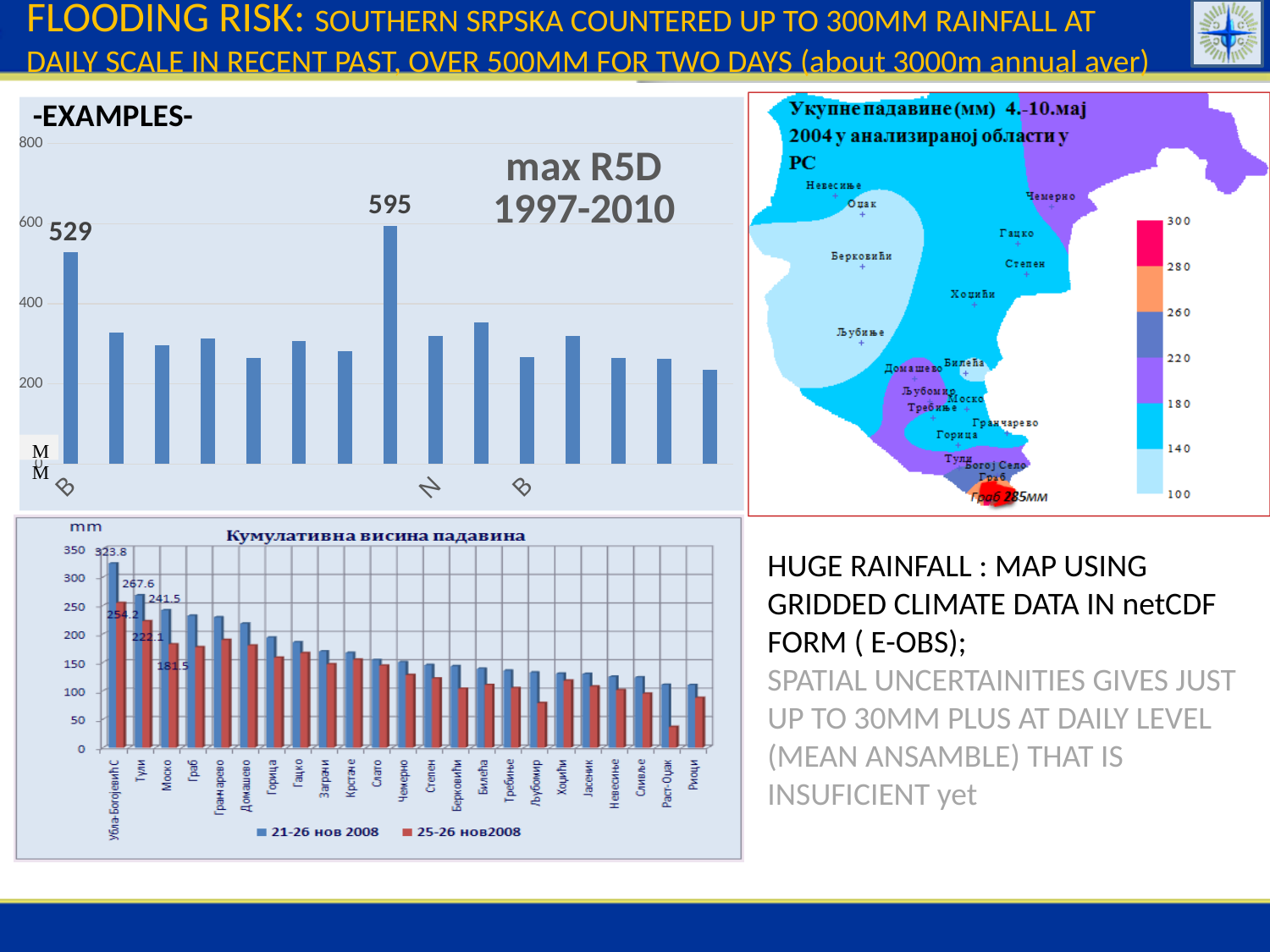
What kind of chart is the 'max R5D 1997-2010' chart at the top left of the slide? bar chart In the 'Кумулативна висина падавина' chart, what is the value for Убла-Богојевић С in the '21-26 нов 2008' series? 323.8 In the 'max R5D 1997-2010' chart, what value is labelled on the first bar? 529 In the 'Кумулативна висина падавина' chart, what is the difference between the two series values for Убла-Богојевић С (323.8 and 254.2)? 69.6 How many series does the legend of the 'Кумулативна висина падавина' chart list? 2 In the 'max R5D 1997-2010' chart, what is the difference between the two labelled values, 595 and 529? 66 In the 'Кумулативна висина падавина' chart, which has the larger '25-26 нов2008' value, Раст-Оџак or Риоци? Риоци In the 'Кумулативна висина падавина' chart, what is the value for Тули in the '25-26 нов2008' series? 222.1 In the 'max R5D 1997-2010' chart, is the value of the second bar greater or less than 400? less In the 'Кумулативна висина падавина' chart, do the '21-26 нов 2008' values generally rise or fall from left to right? fall In the 'max R5D 1997-2010' chart, what is the highest value shown? 595 How many bars are plotted in the 'max R5D 1997-2010' chart? 15